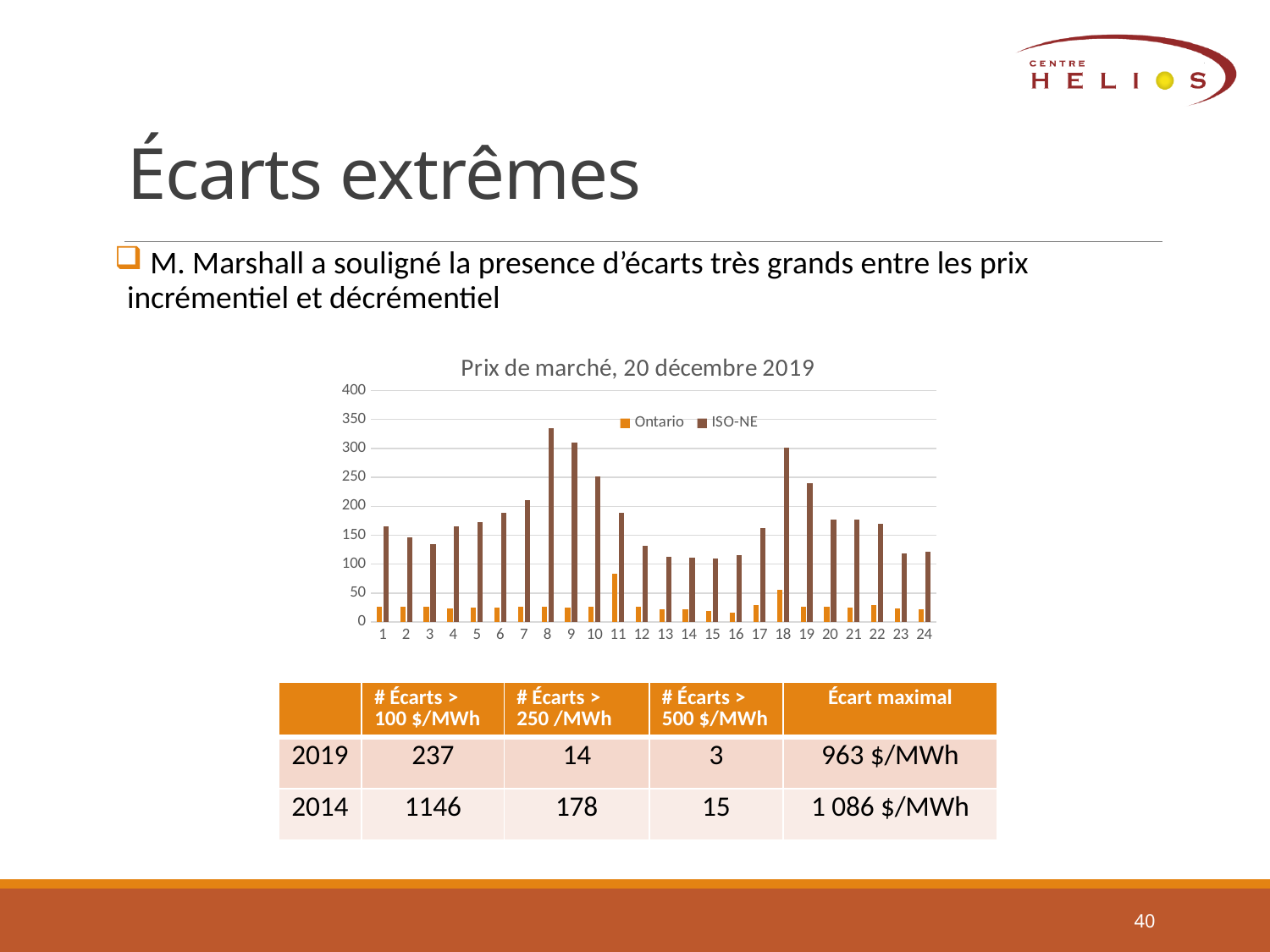
How many series does the chart's legend list? 2 Which series is shown in orange in the chart? Ontario Which is larger for ISO-NE: the value at category 8 or the value at category 10? Category 8 Is the ISO-NE value at category 8 greater or less than 300? greater What kind of chart is shown on the slide? Bar chart Do the ISO-NE values generally rise or fall from category 1 to category 8? Rise At which x-axis category does the Ontario series reach its highest value? 11 How many categories are shown along the x axis of the chart? 24 At which x-axis category does the ISO-NE series reach its highest value? 8 What is the title of the chart? Prix de marché, 20 décembre 2019 Is the ISO-NE value at category 13 greater or less than 150? less Is the Ontario value at category 11 greater or less than 50? greater